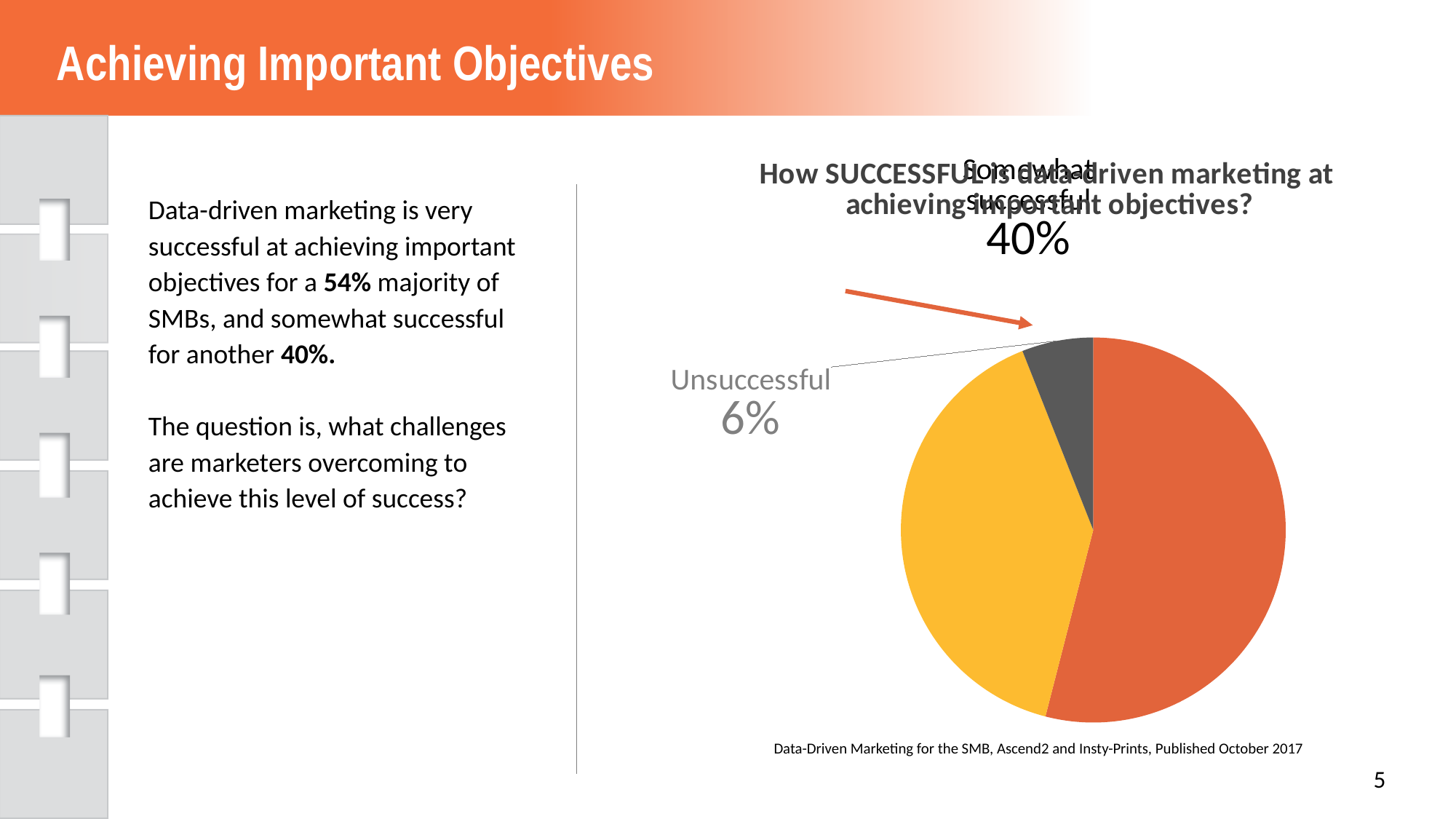
What is the title of the pie chart? How SUCCESSFUL is data-driven marketing at achieving important objectives? How many slices does the pie chart have? 3 What is the difference in percentage points between the 'Somewhat successful' slice (40%) and the 'Unsuccessful' slice (6%)? 34 percentage points What kind of chart is shown on the slide? Pie chart What percentage is shown for the 'Unsuccessful' slice? 6% Which labelled slice of the pie chart is the smallest? Unsuccessful Which colour slice is the largest in the pie chart? Orange What share of the pie does the 'Unsuccessful' slice represent? 6% Which is larger, the 'Somewhat successful' slice or the 'Unsuccessful' slice? Somewhat successful What percentage is shown for the 'Somewhat successful' slice? 40% What colour is the 'Unsuccessful' slice of the pie chart? Dark gray